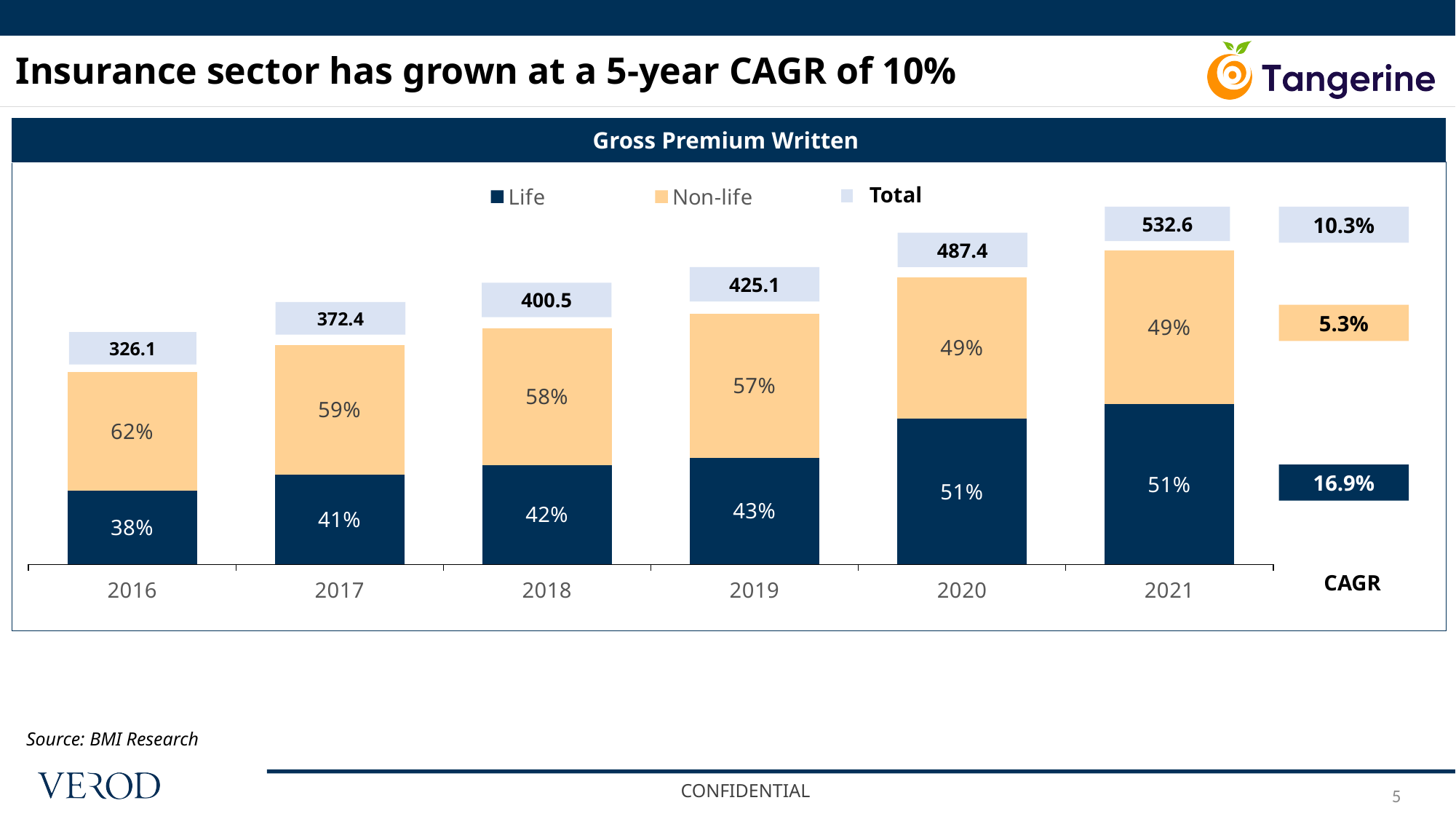
What percentage share does Life have in 2019? 43% How many series does the legend list? 3 What is the total Gross Premium Written shown for 2016? 326.1 What is the total Gross Premium Written shown for 2021? 532.6 Which year has the lowest total Gross Premium Written? 2016 Which is larger, the Life share in 2016 or the Life share in 2020? 2020 What is the CAGR shown for the Life segment? 16.9% How many years are shown on the x axis of the chart? 6 Which year has the highest total Gross Premium Written? 2021 What kind of chart is shown on the slide? Stacked bar chart What is the difference between the total Gross Premium Written in 2021 and in 2016? 206.5 What percentage share does Non-life have in 2017? 59%